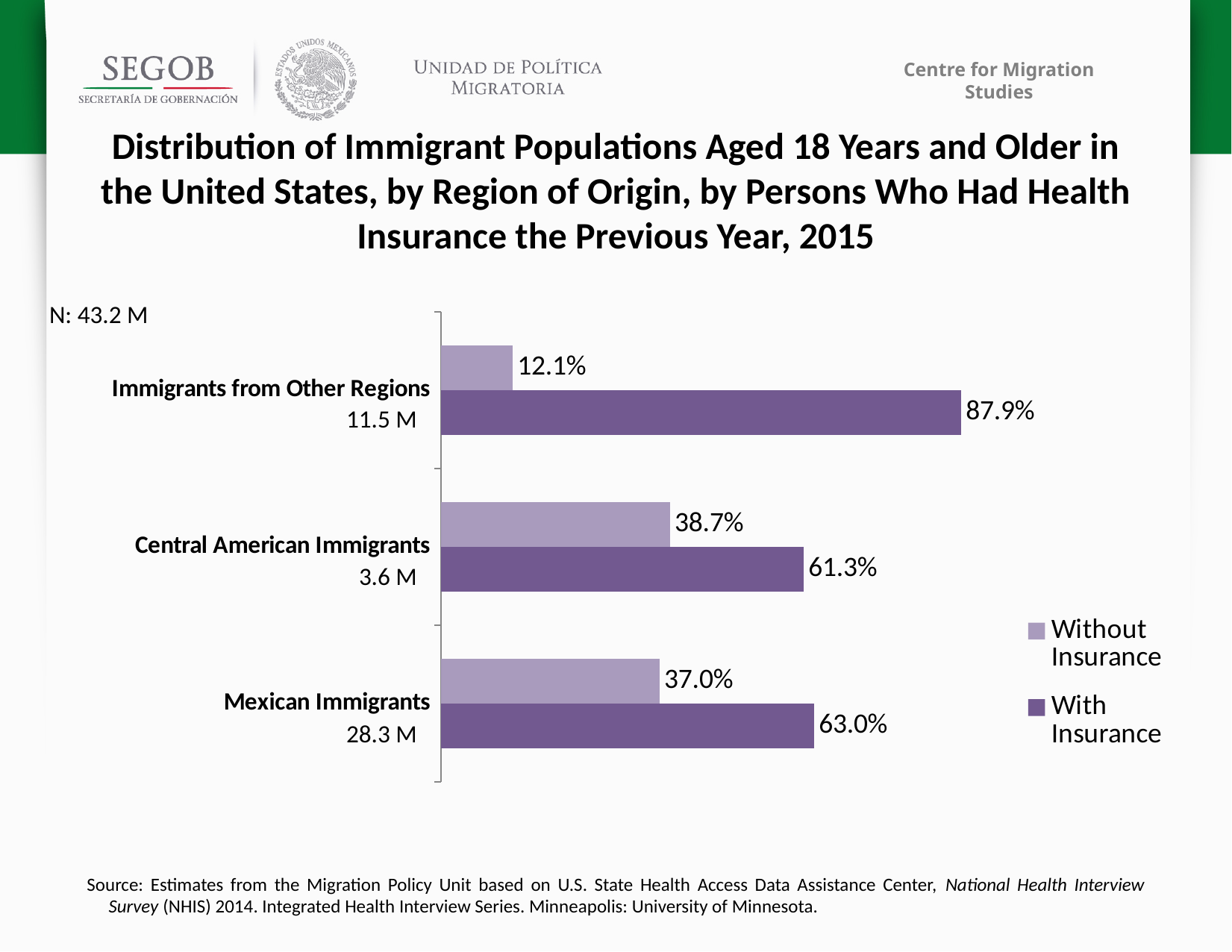
What is the population size shown for Mexican Immigrants? 28.3 M What percentage of Immigrants from Other Regions had insurance? 87.9% What total N is shown for the chart? 43.2 M How many series does the legend list? 2 Which group has the highest share with insurance? Immigrants from Other Regions Which group has the lowest share without insurance? Immigrants from Other Regions Which is larger: the without-insurance share for Central American Immigrants or for Mexican Immigrants? Central American Immigrants What type of chart is shown on the slide? Bar chart How many immigrant groups are shown in the chart? 3 What percentage of Mexican Immigrants were without insurance? 37.0% What percentage of Central American Immigrants had insurance? 61.3% What is the difference between the with-insurance and without-insurance shares for Central American Immigrants? 22.6%